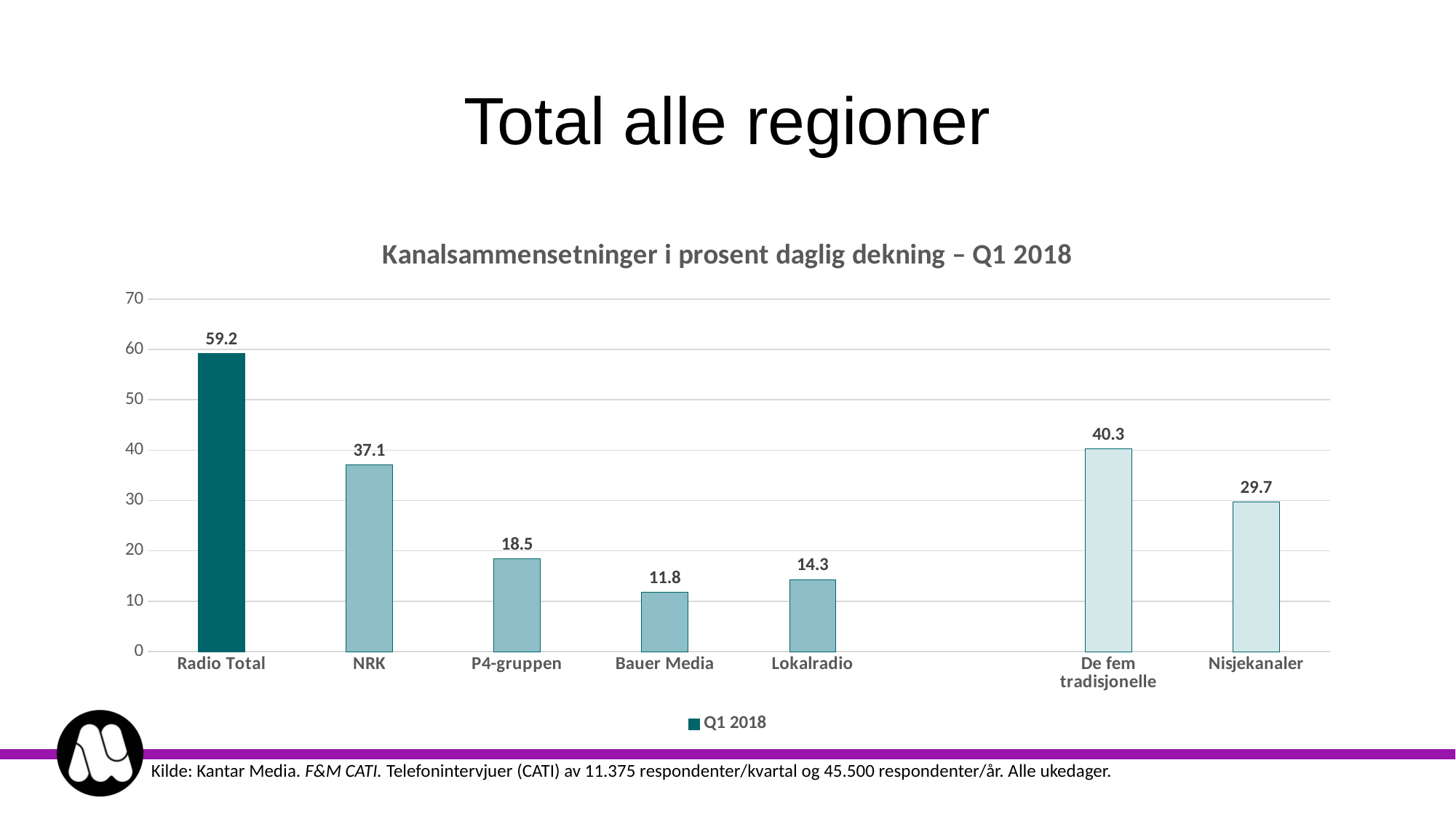
Which category has the lowest value? Bauer Media What is the difference between the values for NRK and P4-gruppen? 18.6 What is the value for NRK? 37.1 What is the value for Radio Total? 59.2 What is the value for De fem tradisjonelle? 40.3 Is the value for Nisjekanaler greater or less than 30? less Which is larger, the value for Lokalradio or the value for Bauer Media? Lokalradio Which category has the highest value? Radio Total What is the value for Bauer Media? 11.8 How many categories are shown on the x axis? 7 What kind of chart is shown on the slide? bar chart What is the title of the chart? Kanalsammensetninger i prosent daglig dekning – Q1 2018